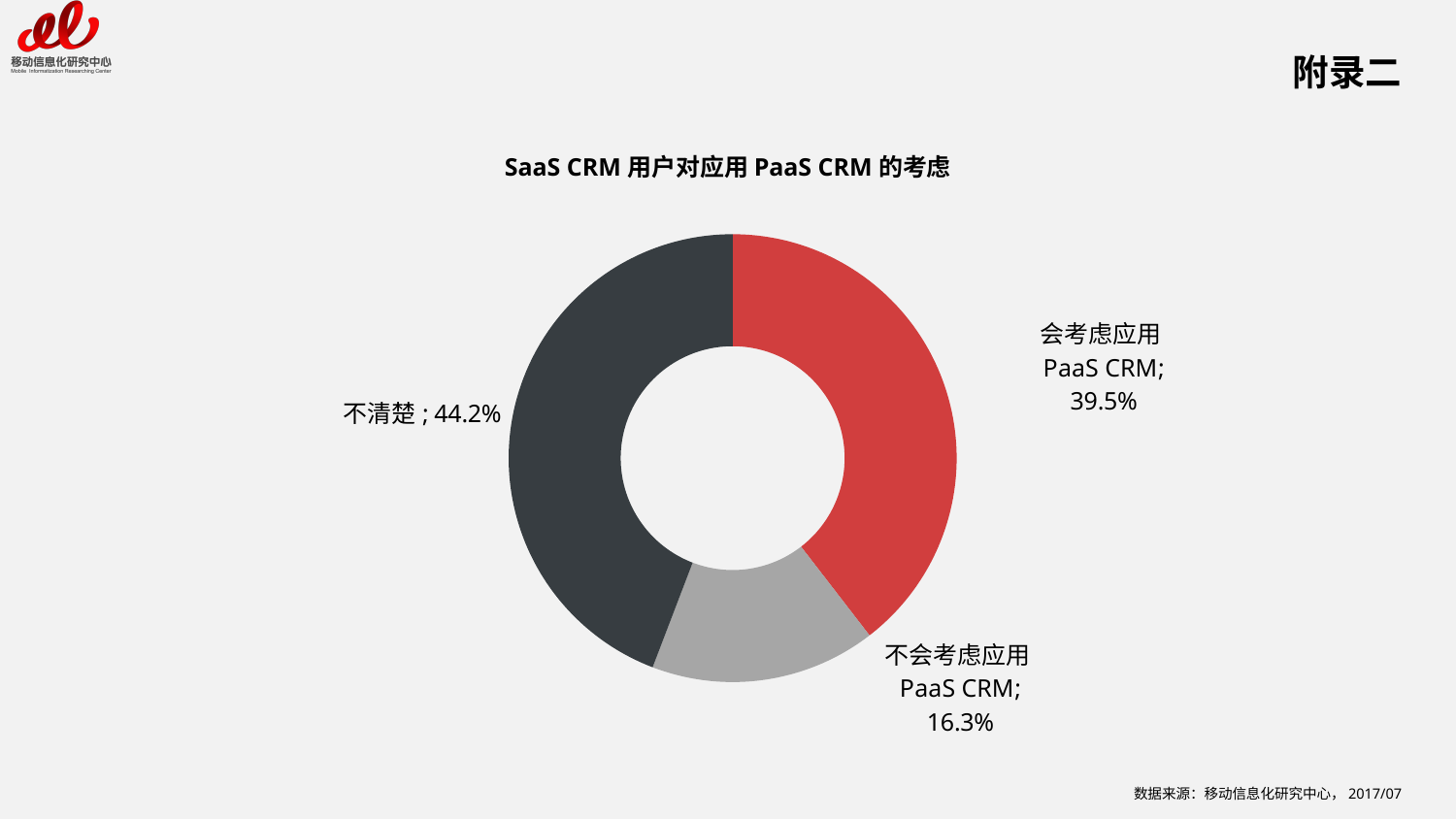
What is the chart's title? SaaS CRM 用户对应用 PaaS CRM 的考虑 What percentage of respondents answered 不会考虑应用 PaaS CRM? 16.3% What percentage of respondents answered 不清楚? 44.2% What is the difference in percentage points between 会考虑应用 PaaS CRM and 不会考虑应用 PaaS CRM? 23.2 What is the difference in percentage points between 不清楚 and 会考虑应用 PaaS CRM? 4.7 Which category has the largest share? 不清楚 What percentage of respondents answered 会考虑应用 PaaS CRM? 39.5% What colour is the slice for 会考虑应用 PaaS CRM? Red Which is larger, the share for 会考虑应用 PaaS CRM or the share for 不会考虑应用 PaaS CRM? 会考虑应用 PaaS CRM Which category has the smallest share? 不会考虑应用 PaaS CRM What kind of chart is shown on the slide? Pie chart (doughnut) How many categories does the pie chart show? 3